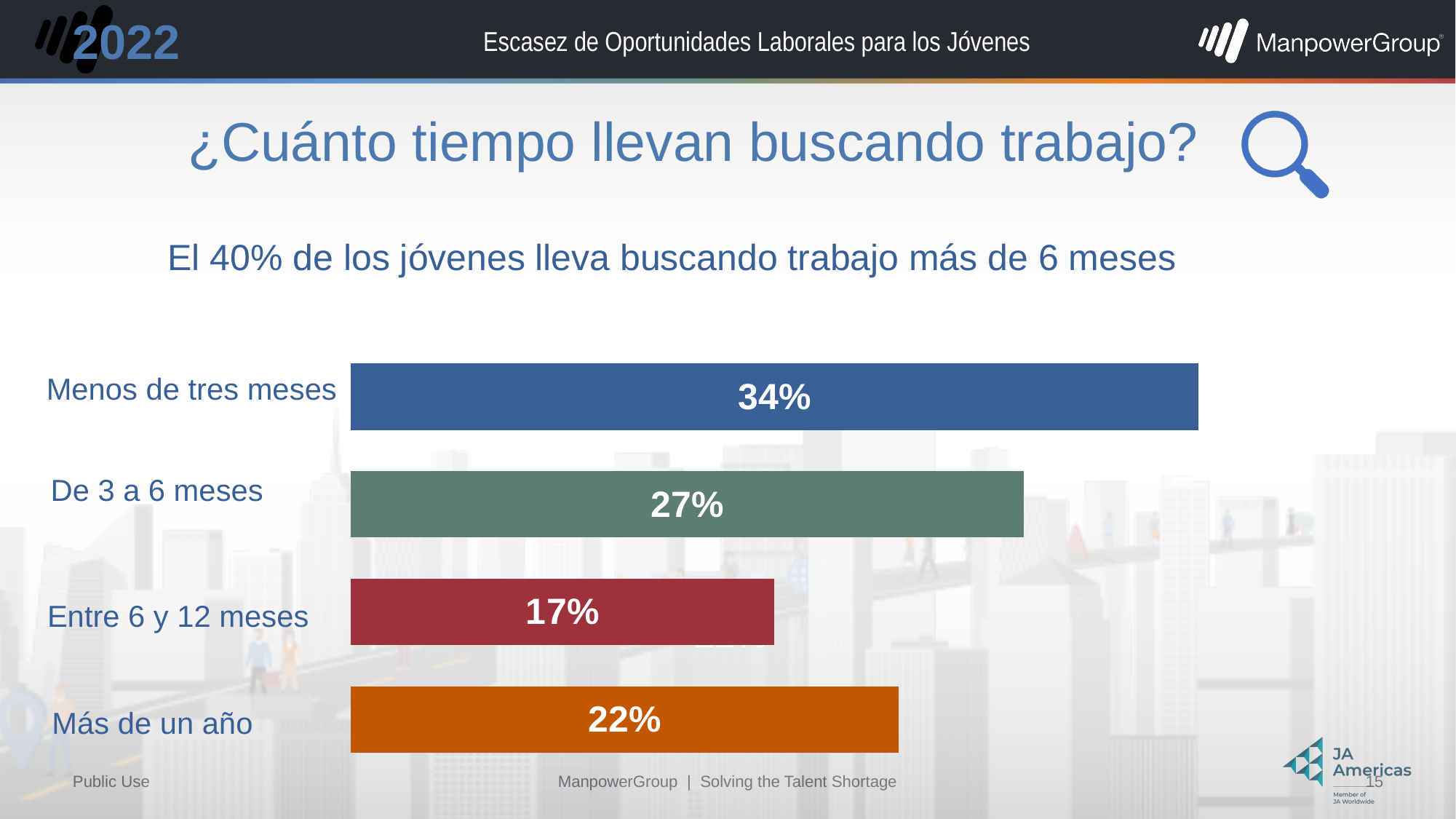
What is the difference between the values for "Más de un año" and "Entre 6 y 12 meses"? 5% What is the value for "Más de un año"? 22% What is the value for "Entre 6 y 12 meses"? 17% What kind of chart is shown on the slide? Bar chart What is the value for "De 3 a 6 meses"? 27% What is the value for "Menos de tres meses"? 34% Which category has the lowest value? Entre 6 y 12 meses How many categories does the chart show? 4 What colour is the bar for "Más de un año"? Orange What is the difference between the values for "Menos de tres meses" and "De 3 a 6 meses"? 7% Which category has the highest value? Menos de tres meses Which is larger, the value for "Más de un año" or the value for "Entre 6 y 12 meses"? Más de un año